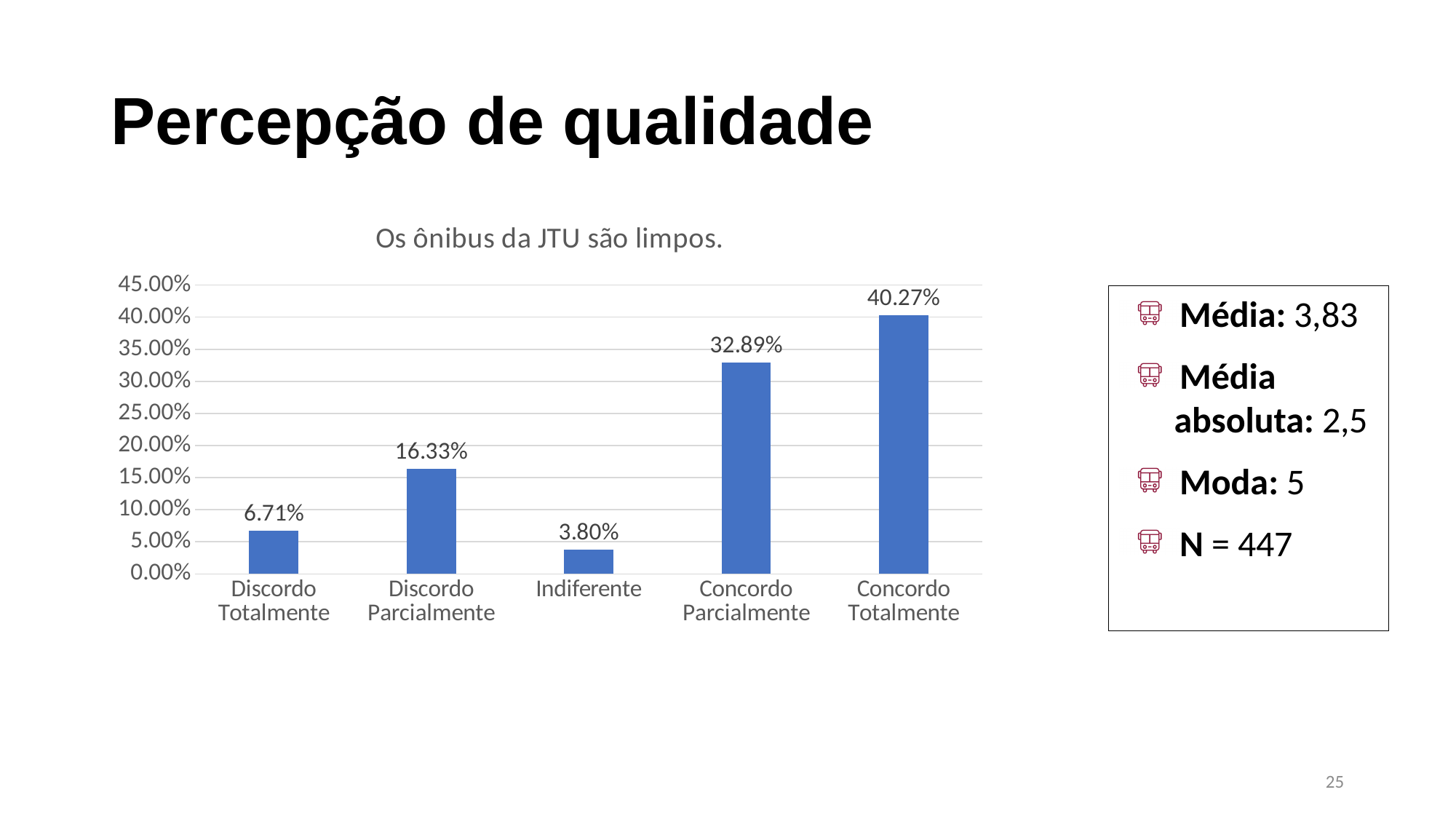
What is the value for Indiferente? 3.80% Which category has the lowest value? Indiferente What is the title of the chart? Os ônibus da JTU são limpos. Which is larger, Discordo Totalmente or Discordo Parcialmente? Discordo Parcialmente How many categories are shown on the x axis? 5 What is the difference between Discordo Parcialmente and Discordo Totalmente? 9.62% Is the value for Concordo Parcialmente greater or less than 30.00%? greater What kind of chart is shown? bar chart What is the value for Discordo Parcialmente? 16.33% What is the difference between Concordo Totalmente and Concordo Parcialmente? 7.38% What is the value for Concordo Totalmente? 40.27% Which category has the highest value? Concordo Totalmente